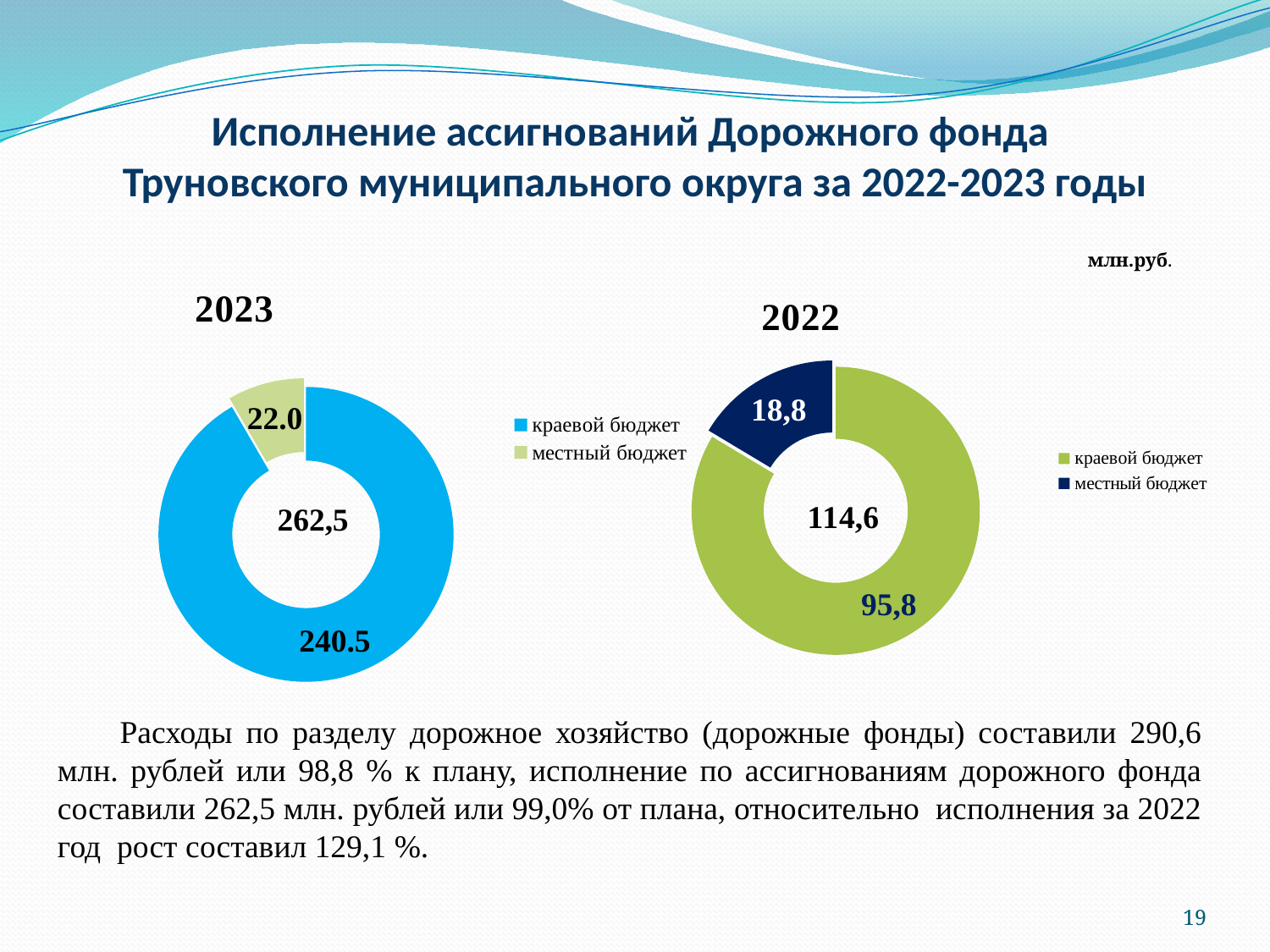
How many slices does the 2022 chart have? 2 In the 2022 chart, what is the difference between краевой бюджет and местный бюджет? 77,0 In the 2023 chart, what is the value for местный бюджет? 22.0 In the 2022 chart, what is the value for местный бюджет? 18,8 In the 2023 chart, which category has the largest slice? краевой бюджет How many series does the legend of the 2023 chart list? 2 What kind of chart is the 2023 chart? Doughnut (pie) chart Which is larger: местный бюджет in the 2023 chart or местный бюджет in the 2022 chart? 2023 (22.0) In the 2023 chart, what is the value for краевой бюджет? 240.5 What total is shown in the centre of the 2022 chart? 114,6 In the 2022 chart, which category has the smallest slice? местный бюджет In the 2022 chart, what is the value for краевой бюджет? 95,8